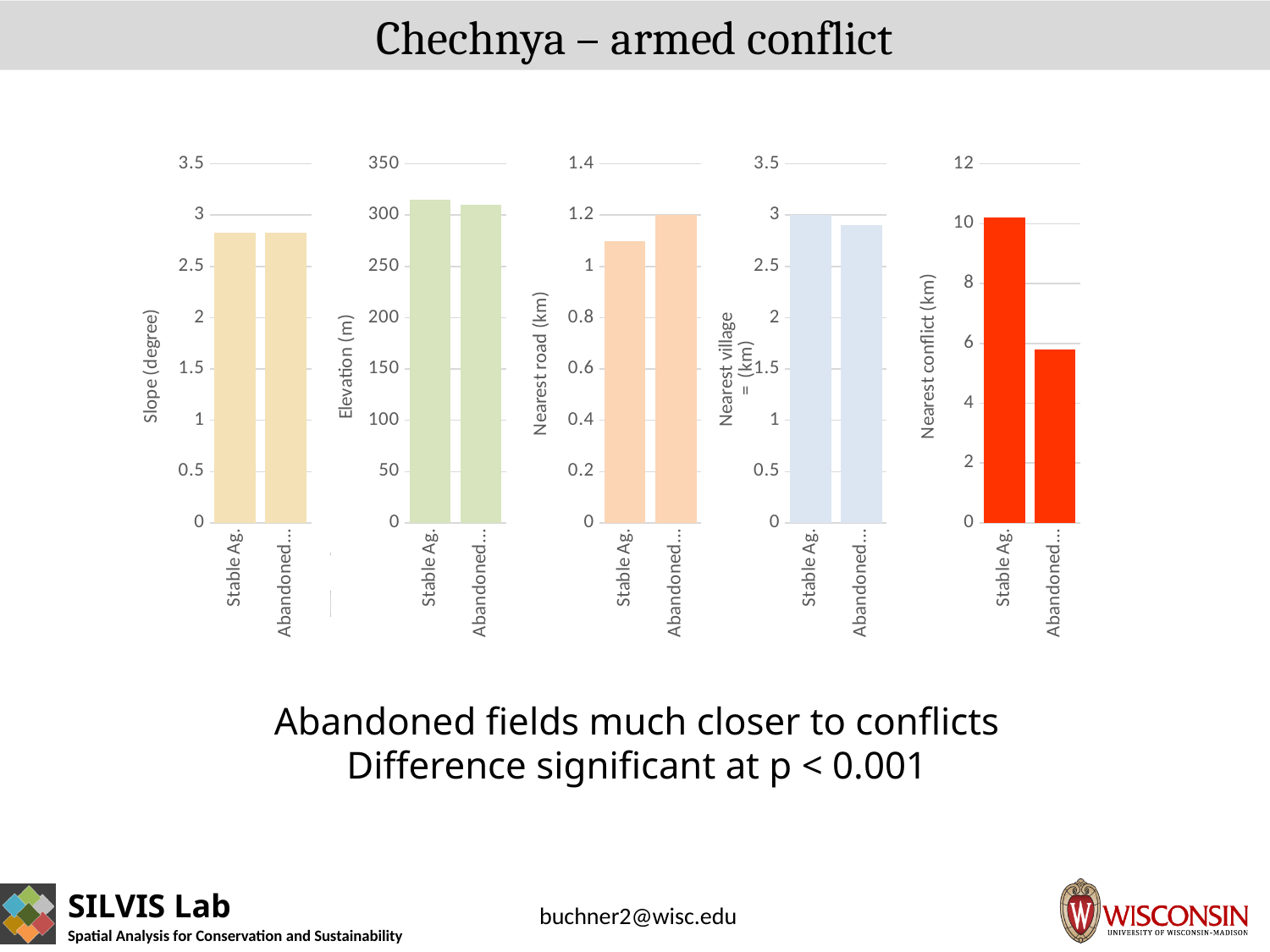
In the Nearest conflict (km) chart, is the value for Abandoned greater or less than 8? less In the Nearest road (km) chart, which category has the higher value, Stable Ag. or Abandoned? Abandoned In the Nearest road (km) chart, is the value for Stable Ag. greater or less than 1? greater In the Nearest conflict (km) chart, which category has the lowest value? Abandoned How many categories are shown on the x axis of the Nearest conflict (km) chart? 2 In the Nearest conflict (km) chart, which category has the higher value, Stable Ag. or Abandoned? Stable Ag. In the Nearest conflict (km) chart, is the value for Stable Ag. greater or less than 8? greater What kind of chart is the Elevation (m) chart? bar chart What colour are the bars in the Nearest conflict (km) chart? red